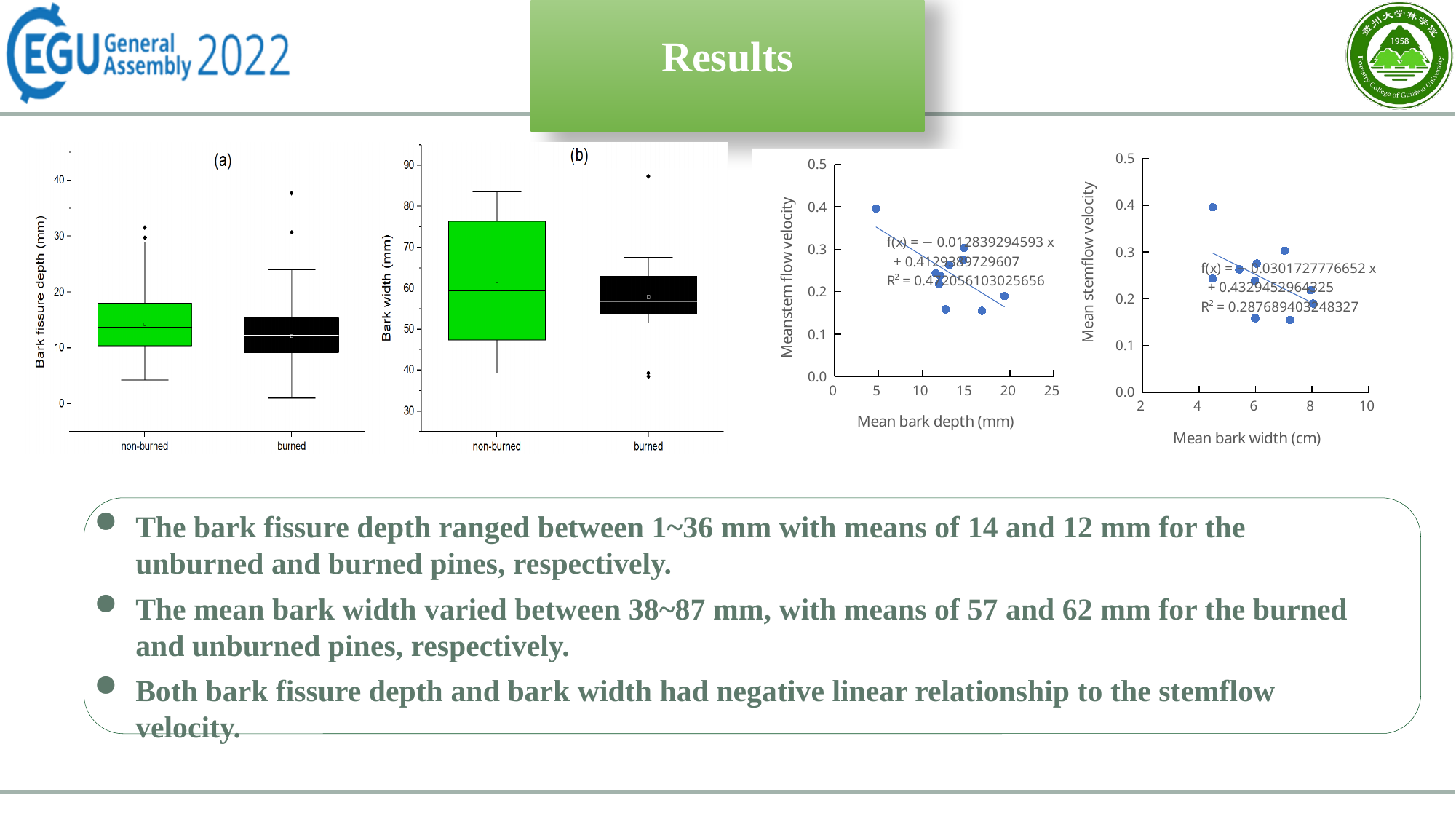
In chart (b), Bark width, is the highest outlier for burned greater or less than 80? greater What is the y axis label of the chart with x axis 'Mean bark width (cm)'? Mean stemflow velocity In the chart with x axis 'Mean bark width (cm)', do the values rise or fall as mean bark width increases? fall What kind of chart is the chart with x axis 'Mean bark depth (mm)'? scatter plot How many categories are shown on the x axis of chart (a), Bark fissure depth? 2 In chart (b), Bark width, which category has the taller (larger) box? non-burned What kind of chart is chart (a), Bark fissure depth? box plot In the chart with x axis 'Mean bark depth (mm)', is the value for the point at about 5 mm greater or less than 0.3? greater In the chart with x axis 'Mean bark depth (mm)', do the values rise or fall as mean bark depth increases? fall In chart (a), Bark fissure depth, which category is drawn with a green box? non-burned What is the R² value printed on the chart with x axis 'Mean bark width (cm)'? 0.287689403248327